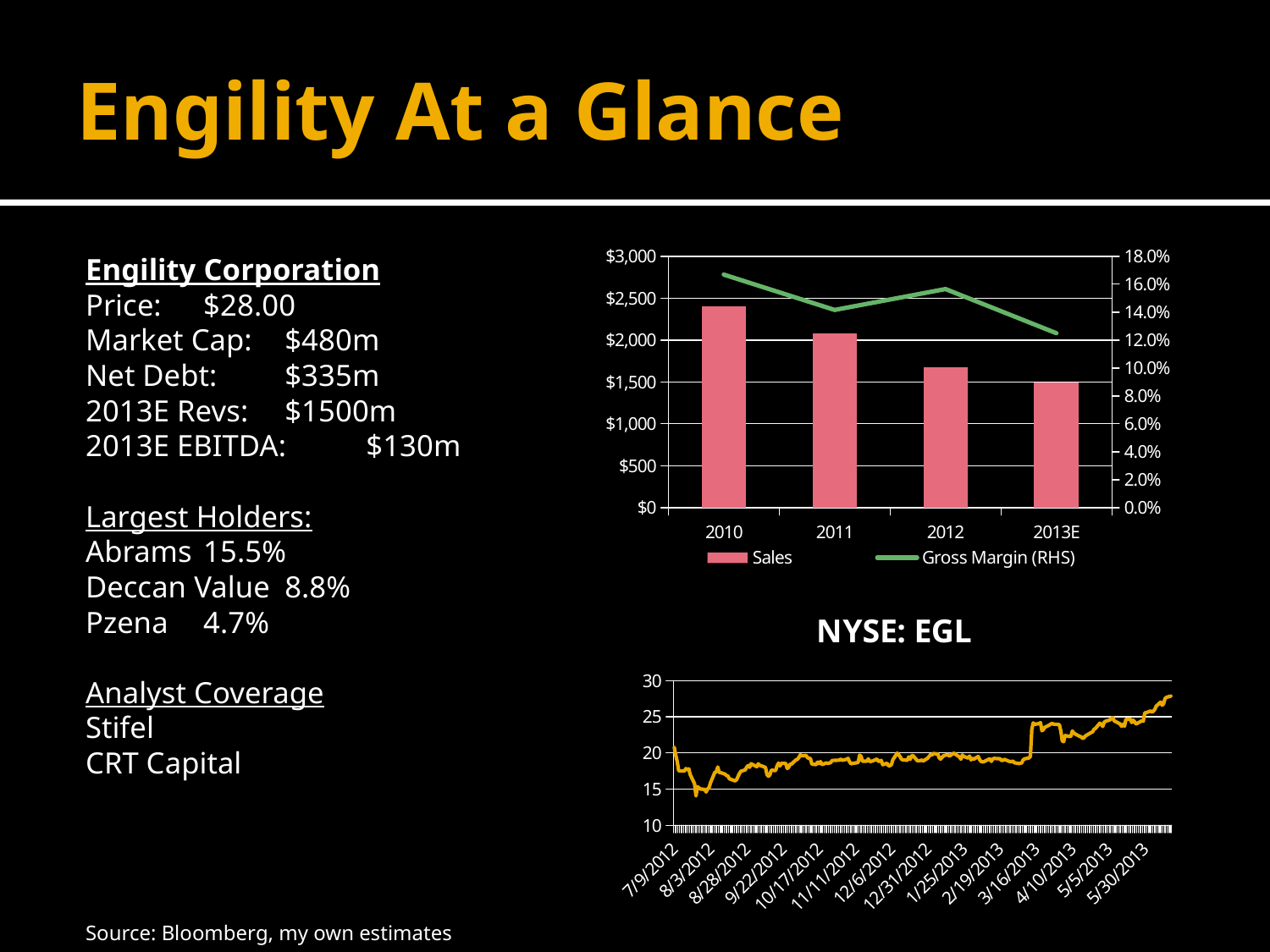
In the top chart, is the Sales value for 2012 greater or less than $2,000? less What type of chart is the bottom chart titled NYSE: EGL? line chart In the top chart, is the Sales value for 2010 greater or less than $2,000? greater In the top chart, do Sales rise or fall from 2010 to 2013E? fall In the top chart, how many series does the legend list? 2 In the top chart, how many years are shown on the x axis? 4 In the top chart, which year has the lowest Gross Margin? 2013E In the top chart, is the Gross Margin for 2010 greater or less than 16.0%? greater In the top chart, which year has the highest Sales? 2010 In the top chart, what are the two series named in the legend? Sales and Gross Margin (RHS) In the top chart, which year has the lowest Sales? 2013E